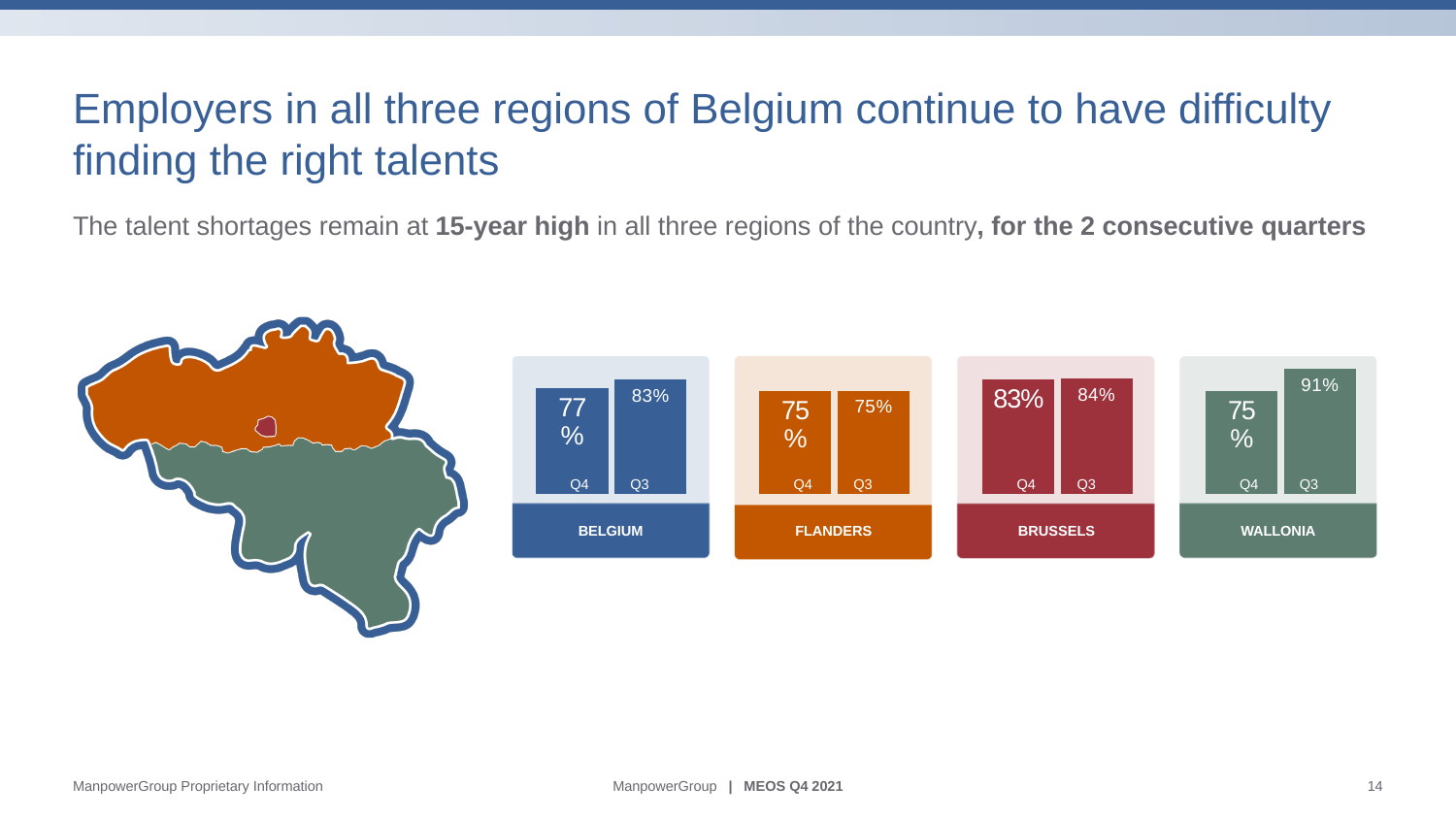
In the WALLONIA chart, what is the value for Q4? 75% In the FLANDERS chart, what is the value for Q3? 75% In the BELGIUM chart, what is the value for Q3? 83% In the BRUSSELS chart, which quarter has the higher value, Q4 or Q3? Q3 In the BELGIUM chart, what is the value for Q4? 77% In the WALLONIA chart, what is the difference between the Q3 and Q4 values? 16% What kind of chart is used for the BRUSSELS panel? Bar chart In the BELGIUM chart, what is the difference between the Q3 and Q4 values? 6% In the BRUSSELS chart, what is the value for Q4? 83% In the WALLONIA chart, which quarter has the lower value? Q4 In the WALLONIA chart, what is the value for Q3? 91% How many bars are shown in the FLANDERS chart? 2